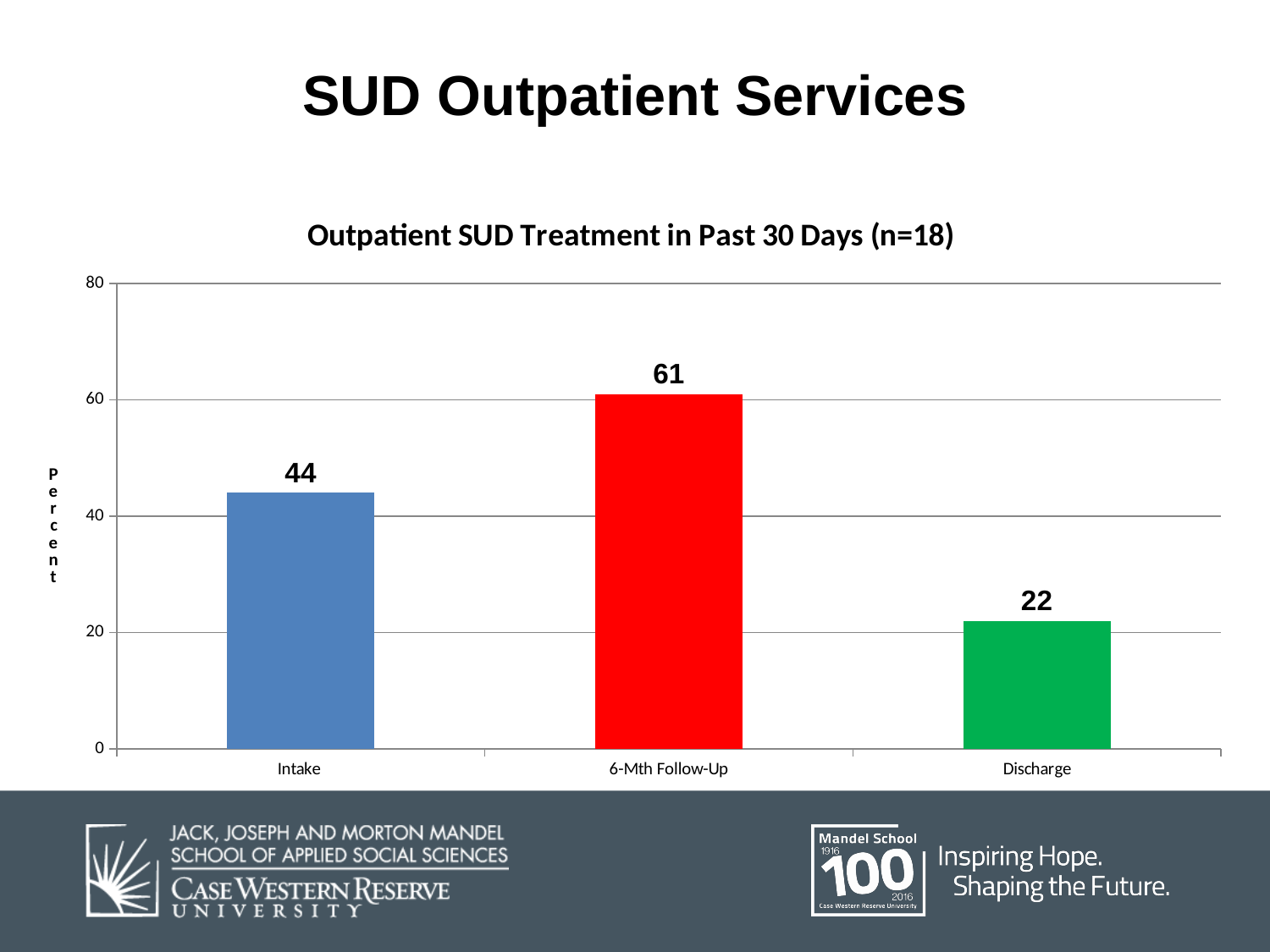
Which category has the lowest value? Discharge What is the title of the chart? Outpatient SUD Treatment in Past 30 Days (n=18) Is the value for 6-Mth Follow-Up greater or less than 60? greater What is the value for Intake? 44 What is the value for Discharge? 22 What is the difference between the values for Intake and Discharge? 22 Which is larger, the value for Intake or the value for Discharge? Intake Which category has the highest value? 6-Mth Follow-Up What is the difference between the values for 6-Mth Follow-Up and Intake? 17 What is the value for 6-Mth Follow-Up? 61 What kind of chart is shown on the slide? bar chart How many categories are shown on the x axis? 3